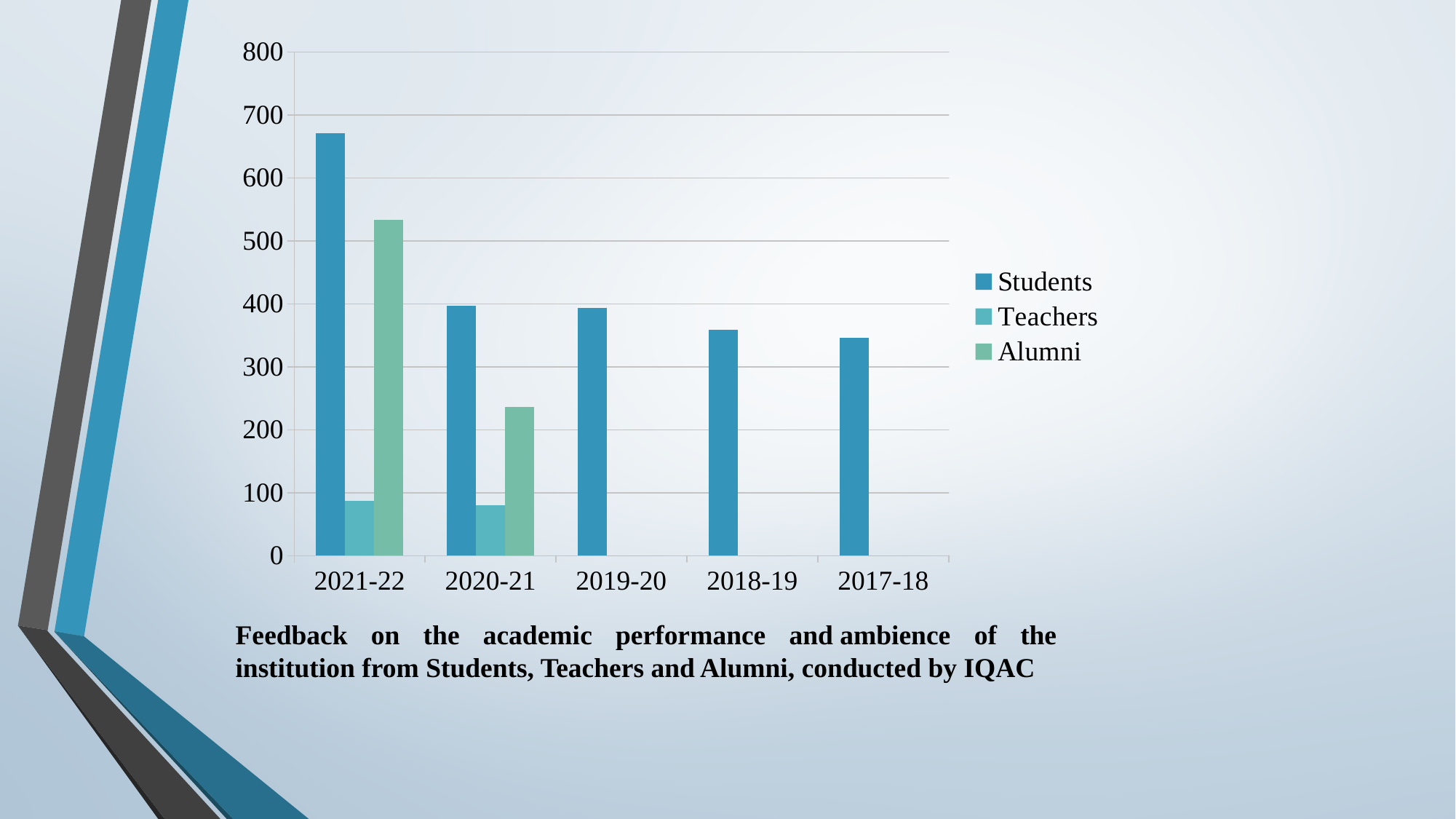
Which is larger, the Alumni value for 2021-22 or the Alumni value for 2020-21? 2021-22 Is the value for Students in 2018-19 greater or less than 400? less Do the Students values rise or fall moving from 2021-22 to 2017-18 along the x axis? fall Which years have bars for the Alumni series? 2021-22 and 2020-21 What kind of chart is shown on the slide? bar chart How many academic years are shown on the x axis? 5 How many series does the legend list? 3 Is the value for Students in 2021-22 greater or less than 600? greater Which year has the highest value for Students? 2021-22 Is the value for Alumni in 2020-21 greater or less than 200? greater